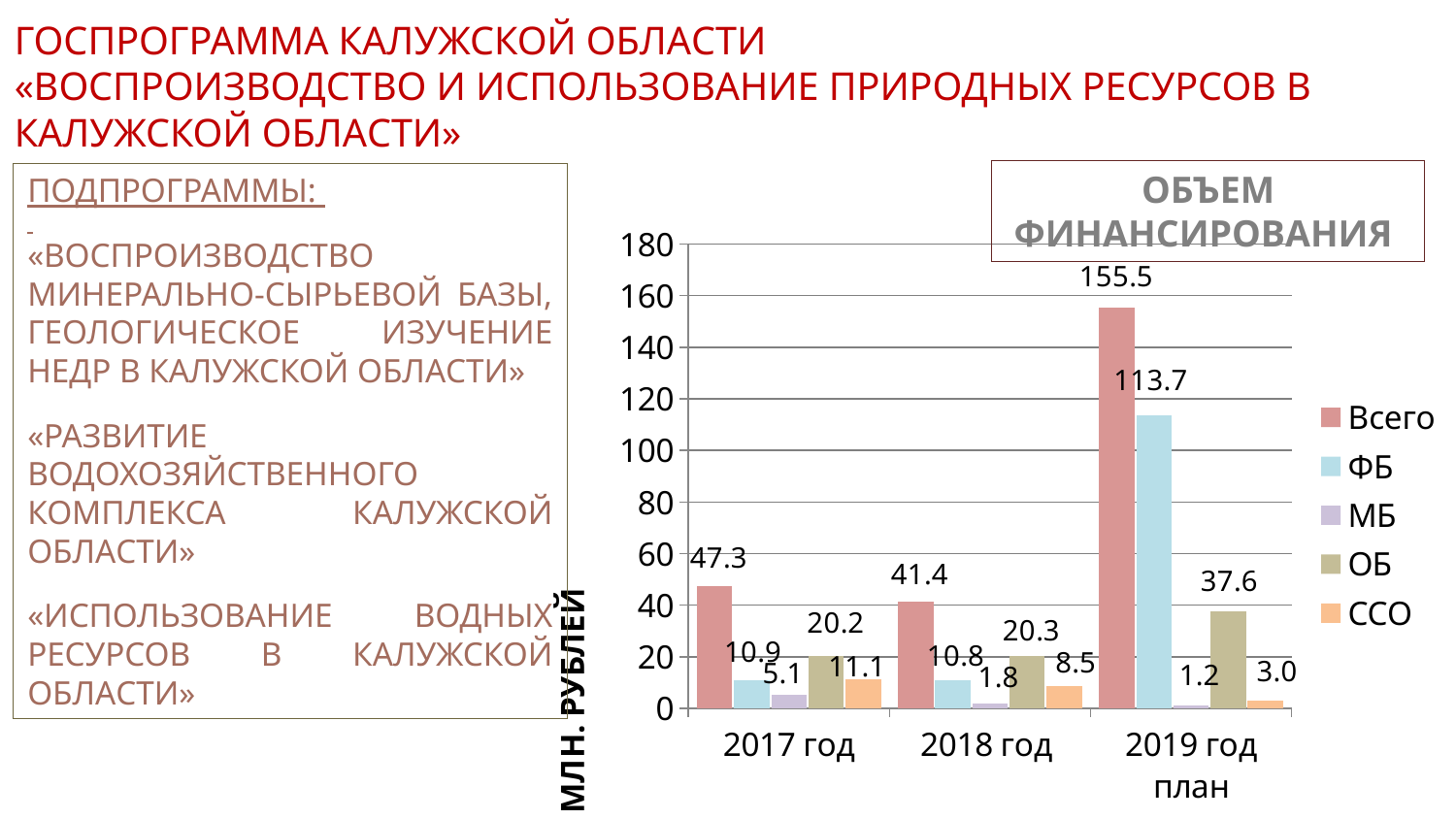
How many series does the legend list? 5 In which year is the Всего value highest? 2019 год план In which year is the МБ value lowest? 2019 год план Which is larger: ССО for 2017 год or ССО for 2018 год? ССО for 2017 год What is the value of Всего for 2019 год план? 155.5 Is the value of ФБ for 2019 год план greater or less than 100? greater How many year categories are shown on the x axis? 3 What is the value of ФБ for 2017 год? 10.9 What is the value of ССО for 2019 год план? 3.0 What is the value of ОБ for 2018 год? 20.3 What type of chart is shown on the slide? bar chart What is the difference between Всего for 2019 год план and Всего for 2018 год? 114.1